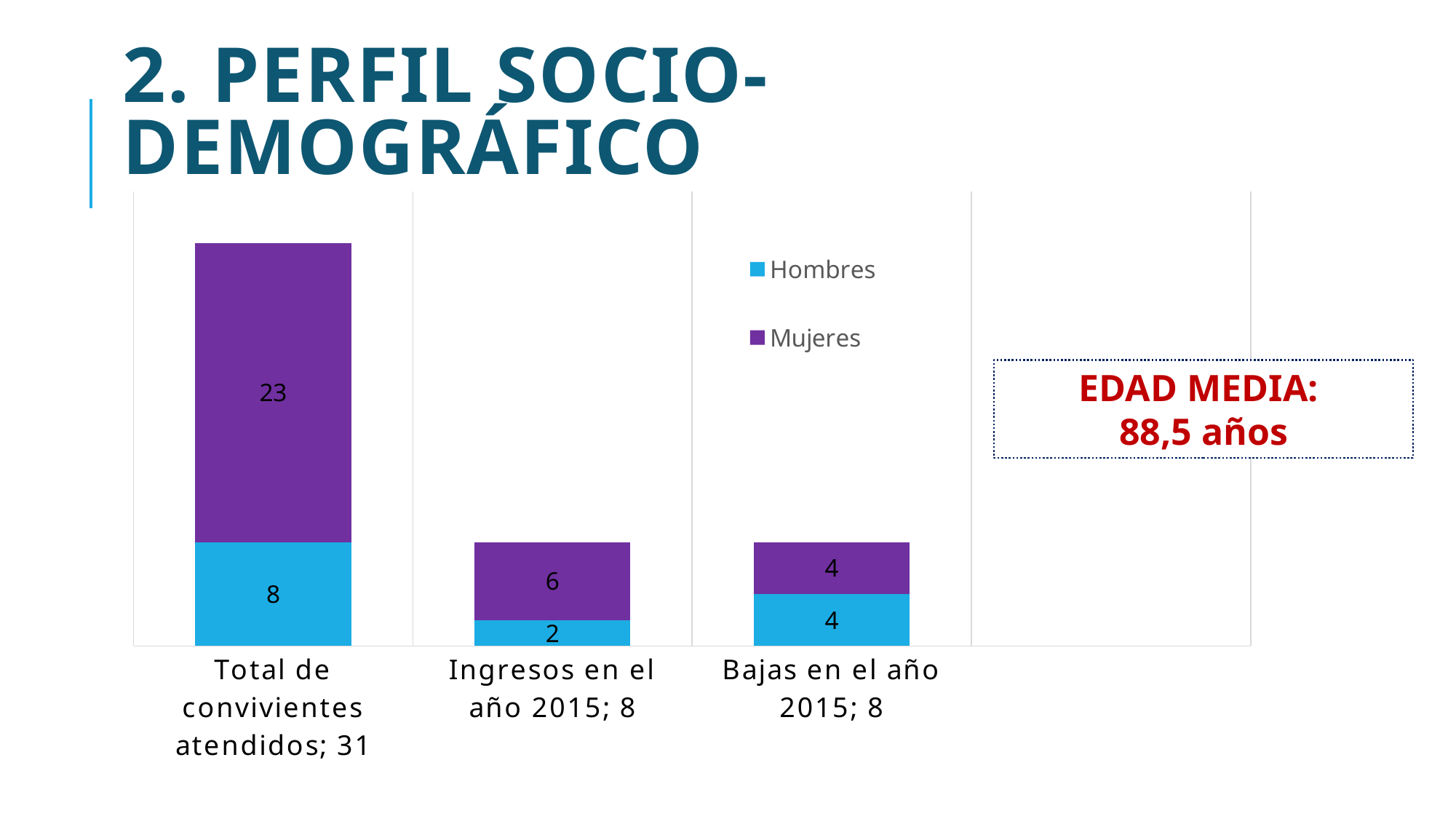
What is the difference between Mujeres and Hombres in the 'Total de convivientes atendidos' bar? 15 Which category has the highest total? Total de convivientes atendidos What is the total of the stacked bar for 'Ingresos en el año 2015'? 8 How many series does the legend list? 2 What is the value for Mujeres in the 'Bajas en el año 2015' bar? 4 What is the value for Mujeres in the 'Total de convivientes atendidos' bar? 23 What is the total of the stacked bar for 'Total de convivientes atendidos'? 31 How many categories are shown on the x axis? 3 What kind of chart is shown on the slide? Stacked bar chart In the 'Ingresos en el año 2015' bar, which is larger, Hombres or Mujeres? Mujeres What is the value for Hombres in the 'Ingresos en el año 2015' bar? 2 What is the value for Hombres in the 'Total de convivientes atendidos' bar? 8